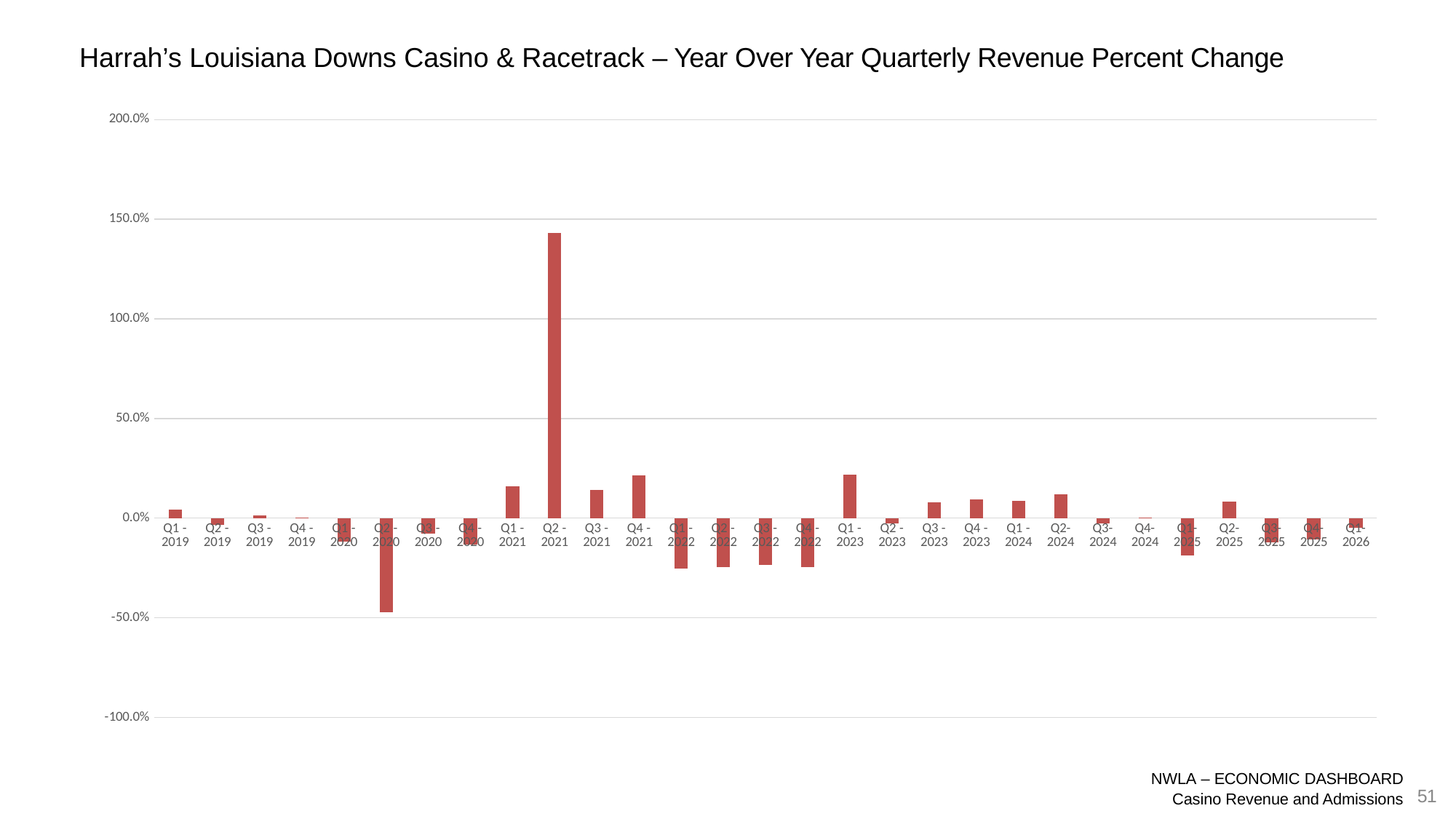
Is the value for Q2 - 2021 greater or less than 100.0%? greater Is the value for Q1 - 2022 greater or less than 0.0%? less Which is larger, the value for Q1 - 2022 or the value for Q1 - 2023? Q1 - 2023 What kind of chart is shown on the slide? bar chart What is the title of the chart? Harrah's Louisiana Downs Casino & Racetrack – Year Over Year Quarterly Revenue Percent Change Is the value for Q2 - 2021 greater or less than 150.0%? less Which quarter has the lowest year over year revenue percent change? Q2 - 2020 Which is larger, the value for Q1 - 2021 or the value for Q2 - 2021? Q2 - 2021 Which is larger, the value for Q2 - 2019 or the value for Q2 - 2020? Q2 - 2019 How many quarters are plotted on the x axis? 29 Which quarter has the highest year over year revenue percent change? Q2 - 2021